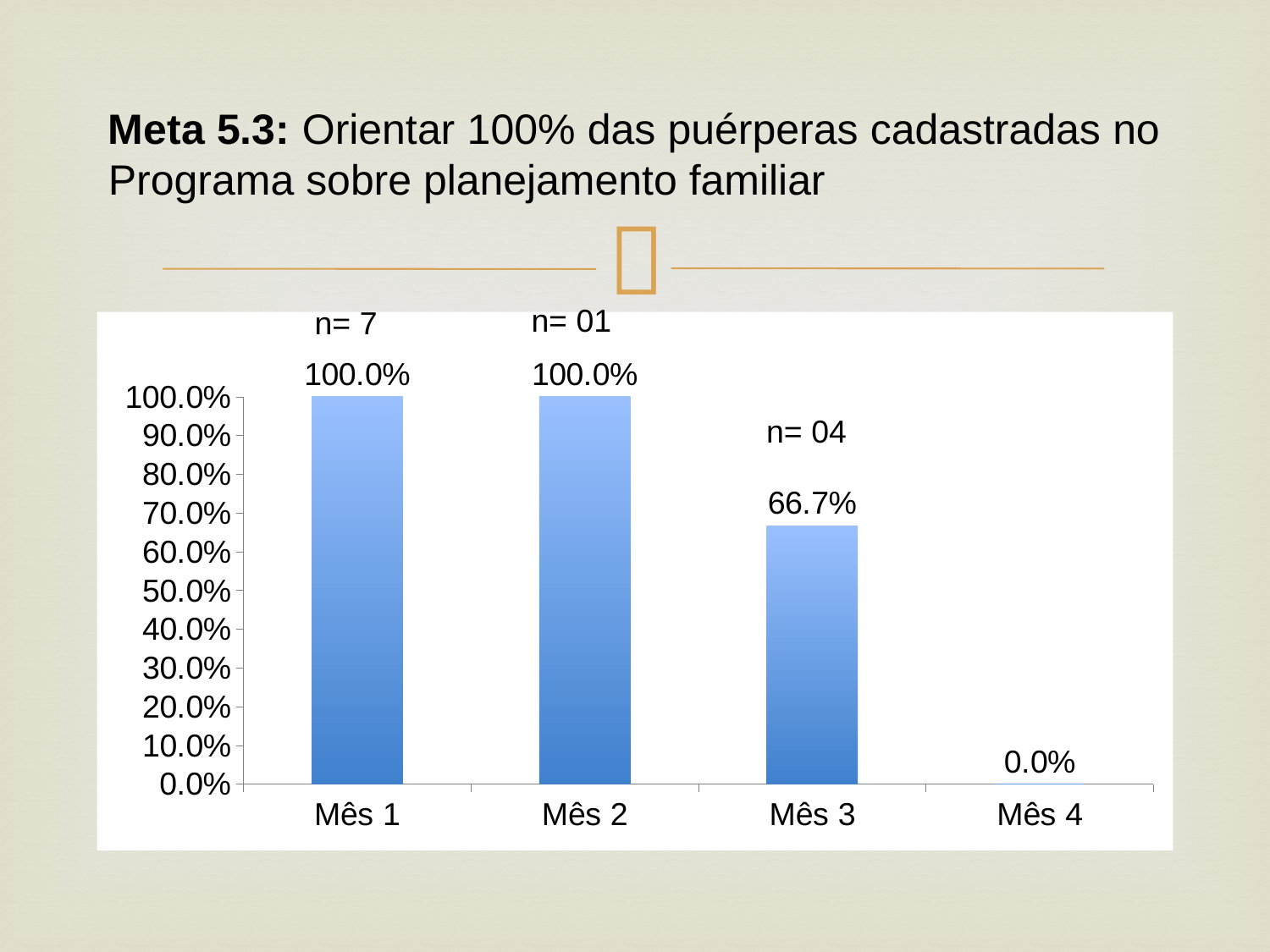
What is the n value annotated above the bar for Mês 3? n= 04 What is the value for Mês 3? 66.7% What is the n value annotated above the bar for Mês 1? n= 7 How many months are shown on the x axis? 4 What is the value for Mês 4? 0.0% Which is larger, the value for Mês 2 or the value for Mês 3? Mês 2 What is the difference between the values for Mês 1 and Mês 3? 33.3% Is the value for Mês 3 greater or less than 60.0%? greater Which month has the lowest value? Mês 4 What is the value for Mês 1? 100.0% Do the values rise or fall from Mês 2 to Mês 4? fall What kind of chart is shown on the slide? bar chart